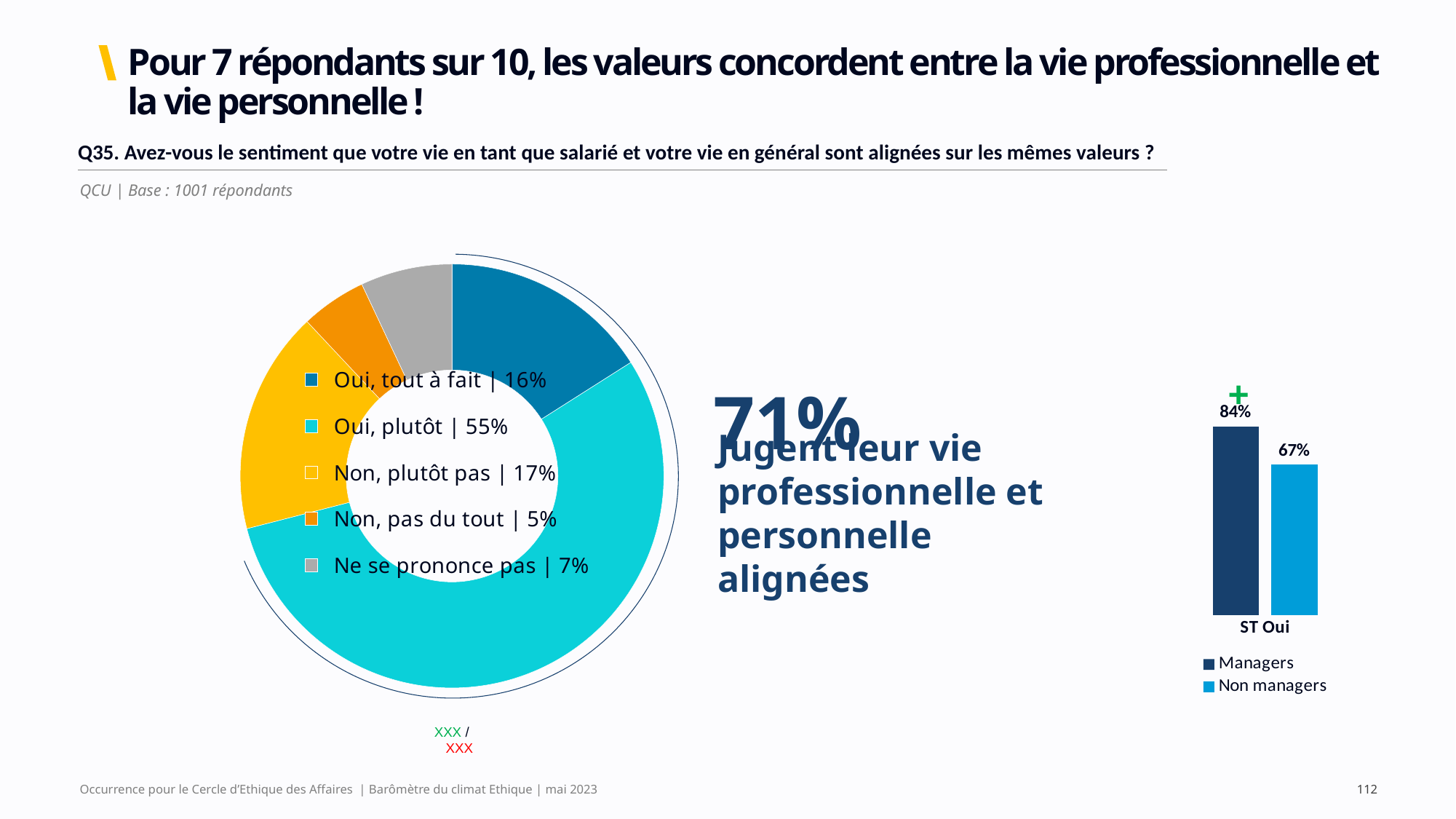
On the donut chart on the left, what is the difference between the shares for "Non, plutôt pas" and "Ne se prononce pas"? 10 percentage points On the bar chart on the right (ST Oui), what is the difference between the Managers and Non managers values? 17 percentage points On the donut chart on the left, what share of respondents answered "Oui, plutôt"? 55% What type of chart is shown on the right side of the slide? Bar chart On the donut chart on the left, which response category has the largest share? Oui, plutôt On the bar chart on the right (ST Oui), what is the value for Non managers? 67% On the donut chart on the left, what share of respondents answered "Non, pas du tout"? 5% On the donut chart on the left, what share of respondents answered "Oui, tout à fait"? 16% On the donut chart on the left, which is larger: the share for "Non, plutôt pas" or the share for "Oui, tout à fait"? Non, plutôt pas On the donut chart on the left, how many response categories are shown in the legend? 5 On the bar chart on the right (ST Oui), what is the value for Managers? 84% On the donut chart on the left, which response category has the smallest share? Non, pas du tout